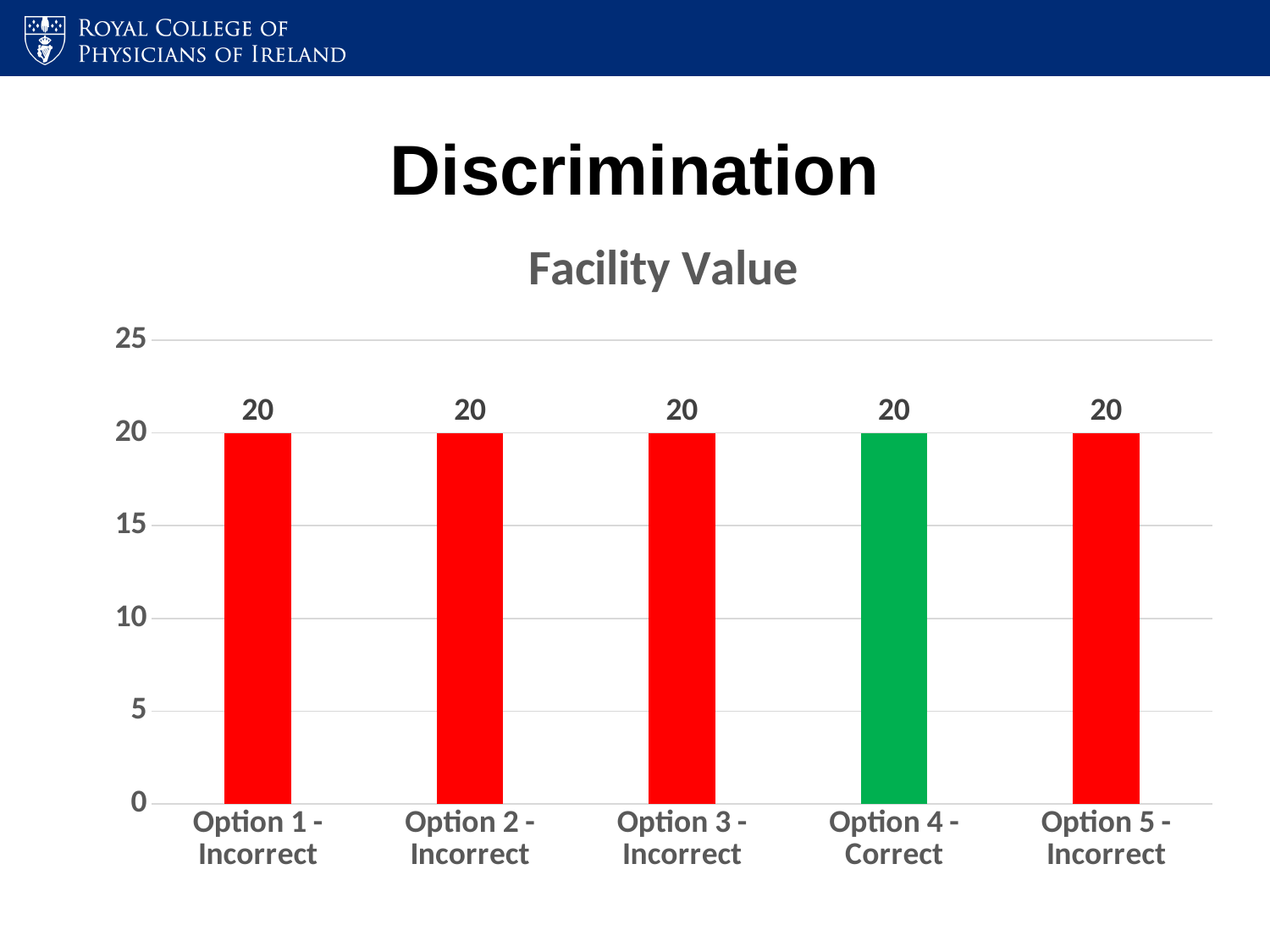
What is the difference between the values for Option 2 - Incorrect and Option 3 - Incorrect? 0 What is the value for Option 1 - Incorrect? 20 What is the total of the values for all five options? 100 Is the value for Option 2 - Incorrect greater or less than 25? less Is the value for Option 3 - Incorrect greater or less than 15? greater What is the value for Option 5 - Incorrect? 20 Do the values rise, fall or stay the same across the categories from left to right? stay the same How many categories are shown on the x axis? 5 What is the title of the chart? Facility Value Which category's bar is coloured green? Option 4 - Correct What kind of chart is shown on the slide? bar chart What is the value for Option 4 - Correct? 20